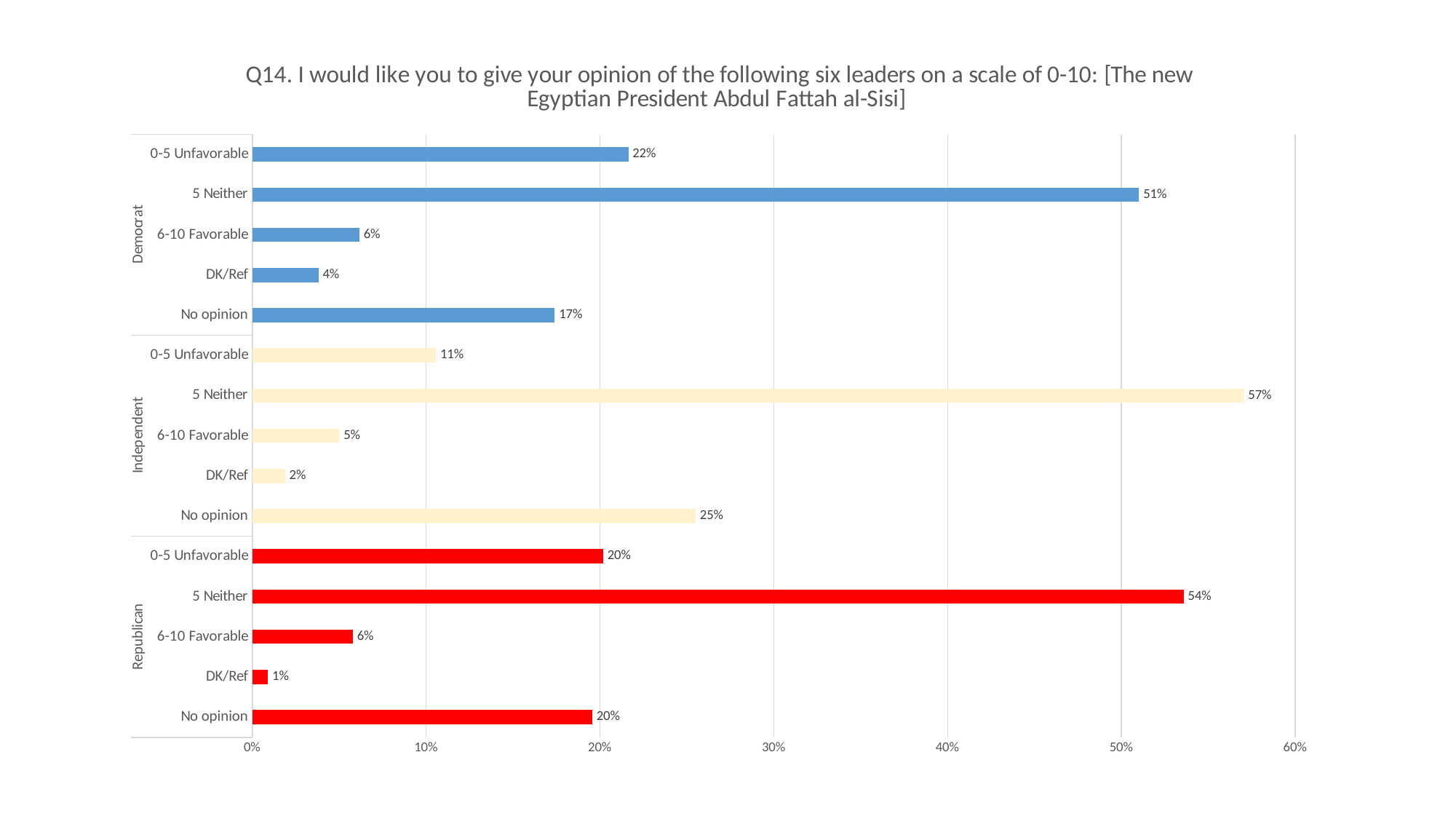
How many bars are plotted on the chart? 15 What is the difference between the '0-5 Unfavorable' percentages for Democrats and Independents? 11% What is the value for DK/Ref among Republicans? 1% What percentage of Republicans gave a '0-5 Unfavorable' rating? 20% What kind of chart is shown on the slide? Bar chart What percentage of Democrats gave a '5 Neither' rating? 51% Is the value for Independent '5 Neither' greater or less than 50%? greater What colour are the bars for the Republican group? Red Which is larger: the 'No opinion' value for Democrats or for Republicans? Republicans Which group has the highest '5 Neither' percentage? Independent Which bar on the chart has the lowest value? Republican DK/Ref What percentage of Independents answered 'No opinion'? 25%